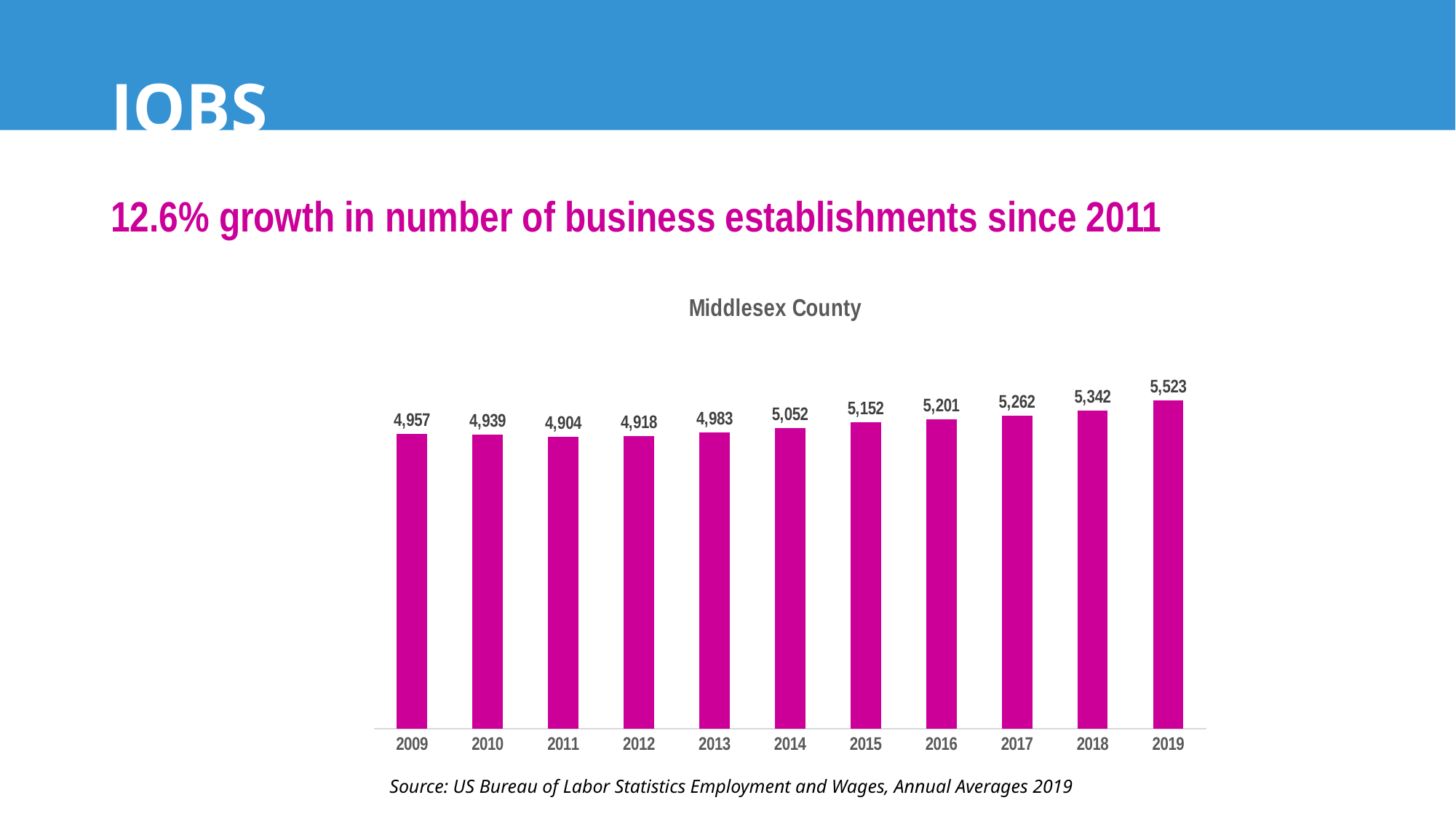
Which is larger in the Middlesex County chart, the value for 2009 or the value for 2012? 2009 Do the values in the Middlesex County chart rise or fall from 2013 to 2019? Rise What is the difference between the values for 2019 and 2011 in the Middlesex County chart? 619 Which year has the lowest value in the Middlesex County chart? 2011 What is the title of the chart on the slide? Middlesex County What is the value for 2019 in the Middlesex County chart? 5,523 Which year has the highest value in the Middlesex County chart? 2019 What kind of chart is the Middlesex County chart? Bar chart How many years are shown on the x axis of the Middlesex County chart? 11 What is the difference between the values for 2018 and 2017 in the Middlesex County chart? 80 What is the value for 2014 in the Middlesex County chart? 5,052 What is the value for 2011 in the Middlesex County chart? 4,904